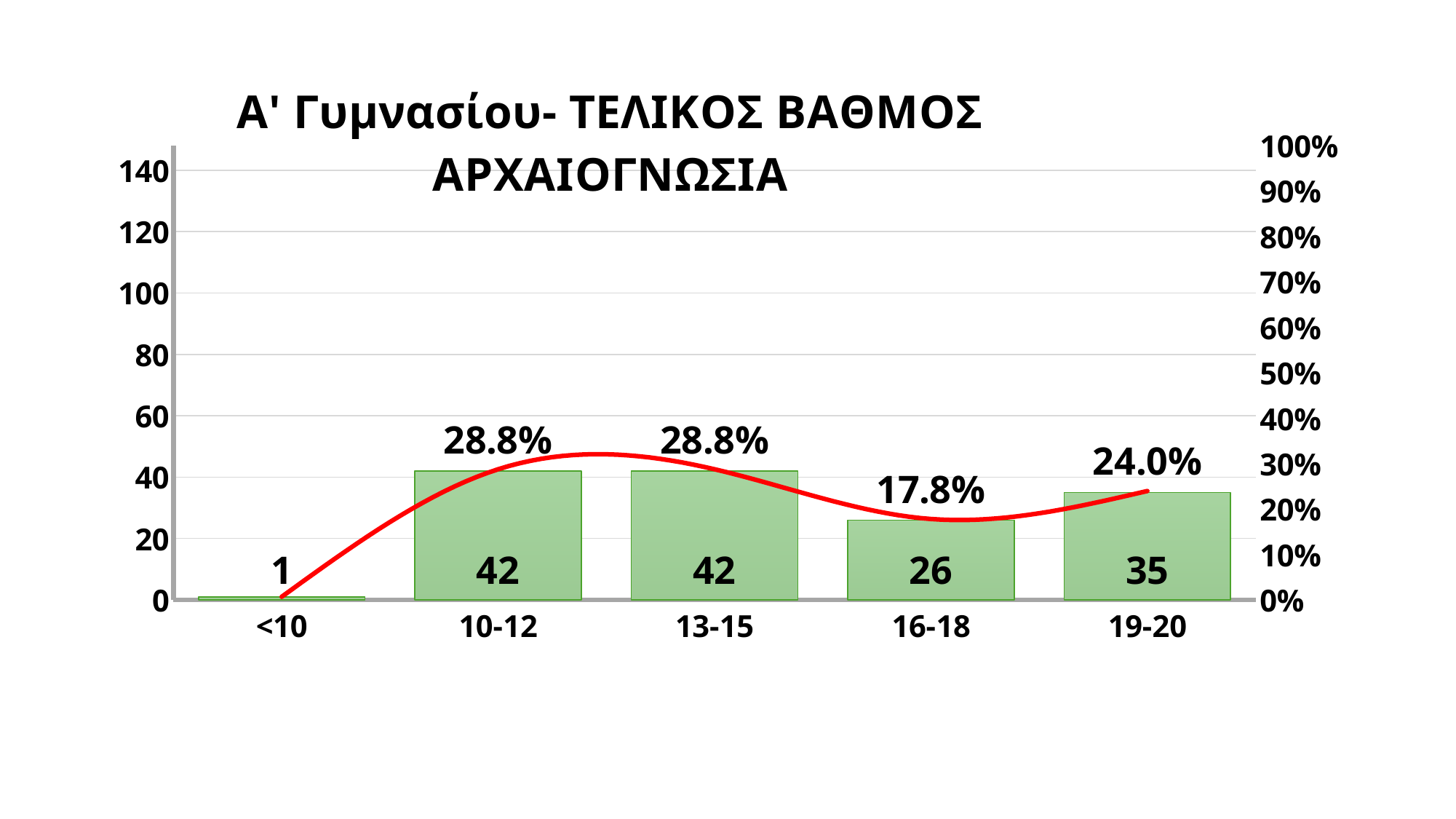
What kind of chart is this? Combined bar and line chart What is the title of the chart? Α' Γυμνασίου- ΤΕΛΙΚΟΣ ΒΑΘΜΟΣ ΑΡΧΑΙΟΓΝΩΣΙΑ What is the difference between the bar values for 13-15 and 16-18? 16 Is the line value for the <10 category greater or less than 10%? less What percentage is shown on the line for the 19-20 category? 24.0% How many categories are shown on the x axis? 5 Which category has the lowest bar value? <10 What is the bar value for the 19-20 category? 35 Which has a larger bar value, 19-20 or 16-18? 19-20 What percentage is shown on the line for the 16-18 category? 17.8% What is the bar value for the 16-18 category? 26 What is the bar value for the 10-12 category? 42